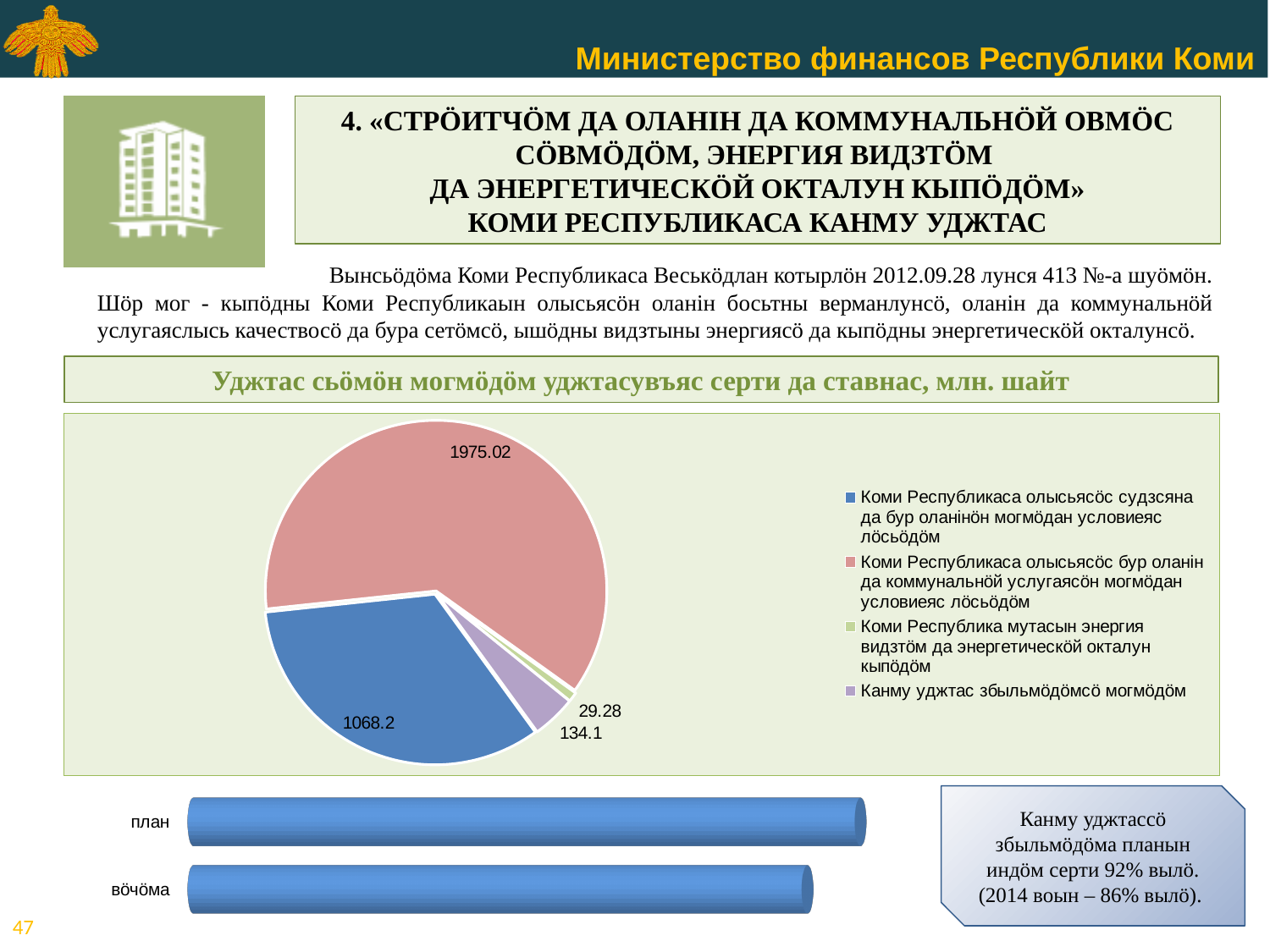
What type of chart is shown at the bottom of the slide with the categories план and вöчöма? bar chart How many entries does the pie chart's legend list? 4 On the pie chart, what value is shown for the blue slice (Коми Республикаса олысьясöс судзсяна да бур оланінöн могмöдан условиеяс лöсьöдöм)? 1068.2 On the pie chart, what value is shown for the green slice (Коми Республика мутасын энергия видзтöм да энергетическöй окталун кыпöдöм)? 29.28 On the pie chart, how many slices are there? 4 What unit is stated in the title above the pie chart? млн. шайт On the pie chart, what is the value of the largest slice? 1975.02 On the pie chart, what is the difference between the largest slice (1975.02) and the blue slice (1068.2)? 906.82 On the pie chart, what is the value of the smallest slice? 29.28 On the pie chart, what value is shown for the purple slice (Канму уджтас збыльмöдöмсö могмöдöм)? 134.1 On the pie chart, which is larger: the purple slice (134.1) or the green slice (29.28)? the purple slice (134.1) On the bar chart at the bottom of the slide, which bar is longer: план or вöчöма? план